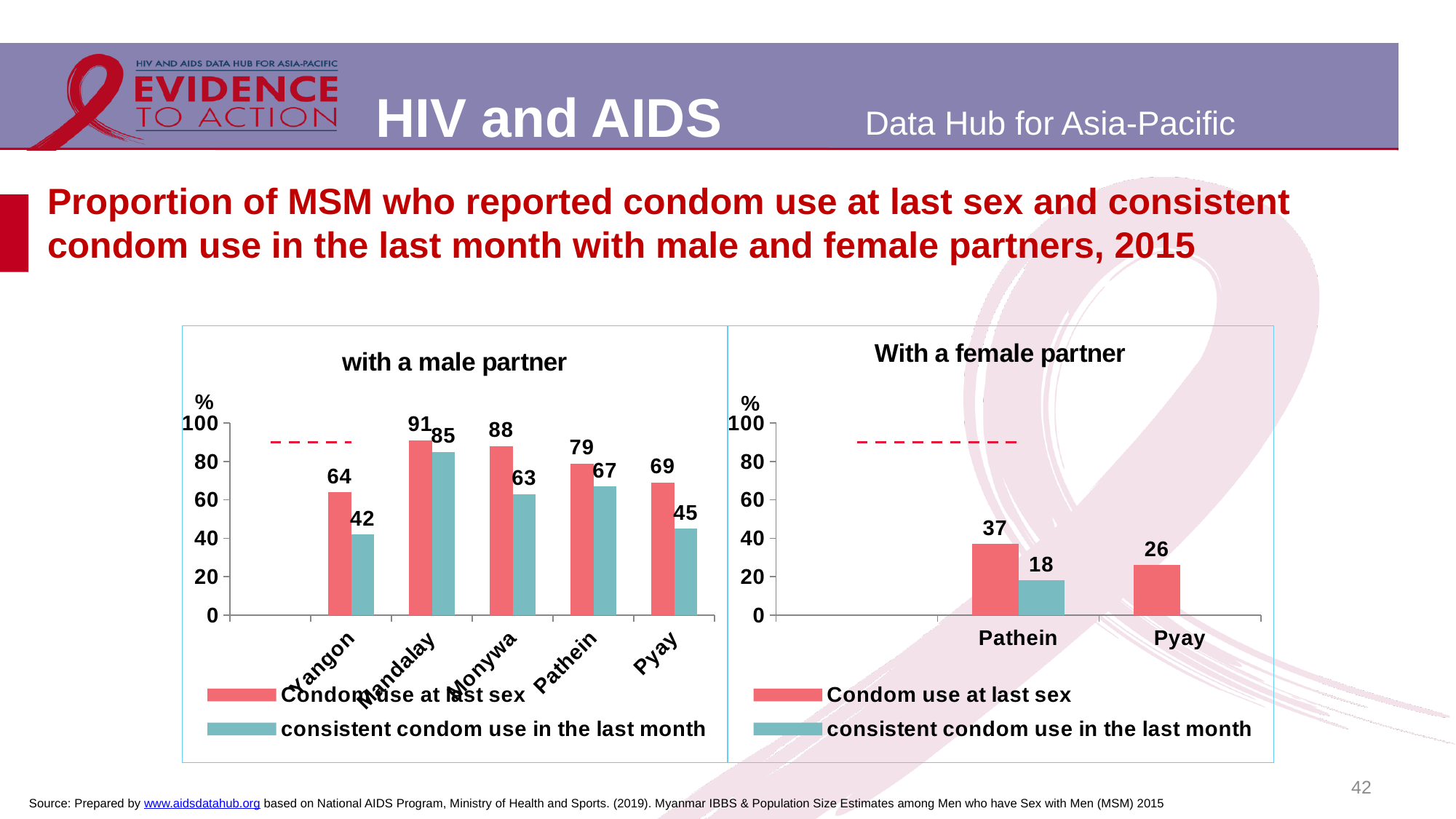
In the 'with a male partner' chart, which is larger: consistent condom use in the last month in Monywa or in Pathein? Pathein In the 'with a male partner' chart, which city has the highest value for condom use at last sex? Mandalay What type of chart is the 'with a male partner' chart? Bar chart How many cities are shown on the x axis of the 'with a male partner' chart? 5 In the 'With a female partner' chart, what is the value for consistent condom use in the last month in Pathein? 18 In the 'with a male partner' chart, what is the difference between condom use at last sex and consistent condom use in the last month in Pyay? 24 In the 'With a female partner' chart, what is the value for condom use at last sex in Pyay? 26 How many series does the legend of the 'With a female partner' chart list? 2 In the 'with a male partner' chart, what is the value for condom use at last sex in Yangon? 64 In the 'With a female partner' chart, what is the value for condom use at last sex in Pathein? 37 In the 'with a male partner' chart, which city has the lowest value for consistent condom use in the last month? Yangon In the 'with a male partner' chart, what is the value for consistent condom use in the last month in Mandalay? 85